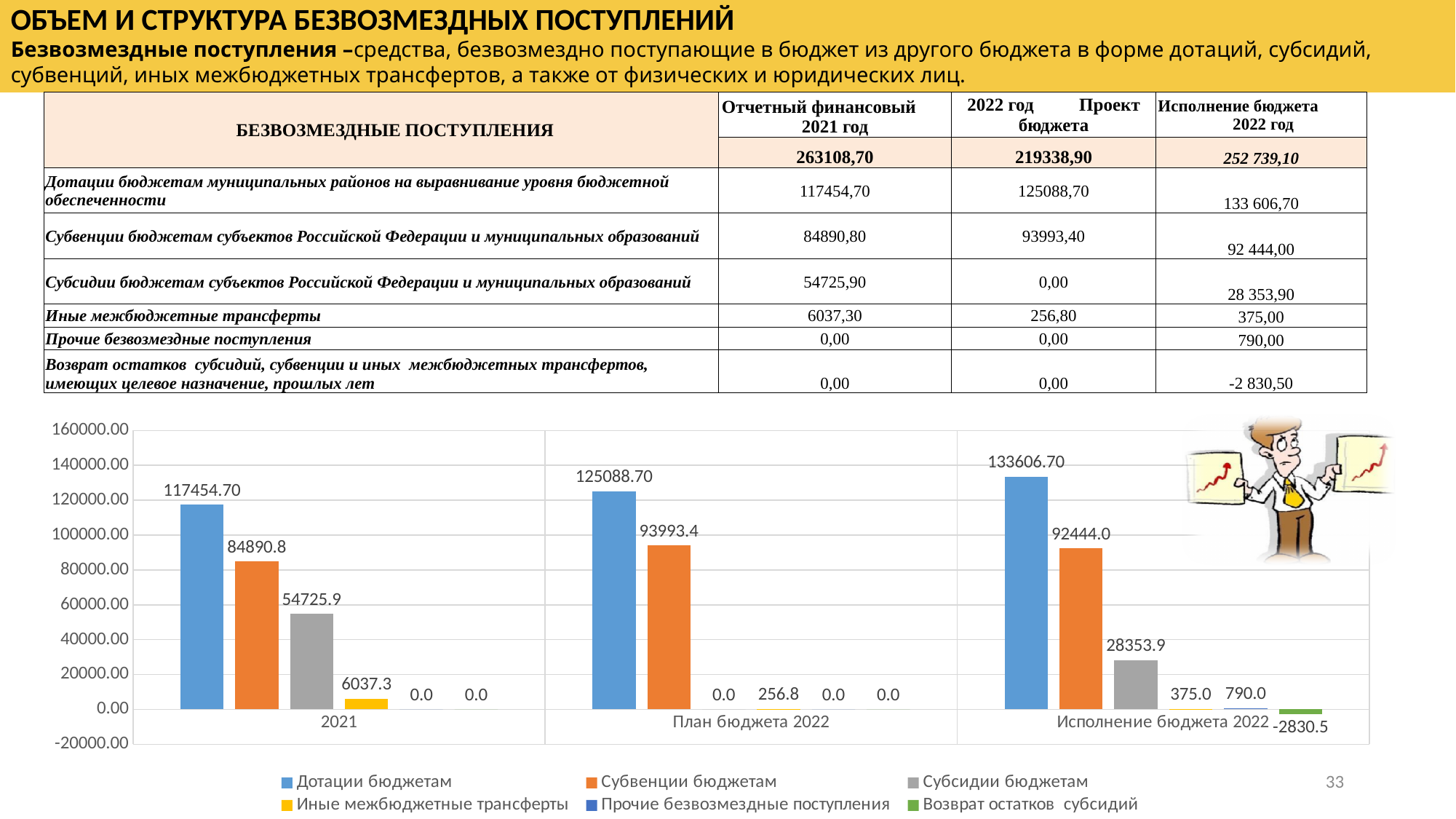
How many series does the chart legend list? 6 What is the difference between Субсидии бюджетам for 2021 and for Исполнение бюджета 2022 in the chart? 26372.0 What is the value of Возврат остатков субсидий for Исполнение бюджета 2022 in the chart? -2830.5 What type of chart is shown on the slide? bar chart In which category does Дотации бюджетам reach its highest value in the chart? Исполнение бюджета 2022 How many categories are shown on the x axis of the chart? 3 By how much does Дотации бюджетам for Исполнение бюджета 2022 exceed Дотации бюджетам for План бюджета 2022 in the chart? 8518.00 Which is larger in the chart: Субвенции бюджетам for План бюджета 2022 or for Исполнение бюджета 2022? План бюджета 2022 Is the value of Субсидии бюджетам for 2021 greater or less than 60000.00? less What is the value of Дотации бюджетам for 2021 in the chart? 117454.70 In which category is Субсидии бюджетам lowest in the chart? План бюджета 2022 What is the value of Субвенции бюджетам for Исполнение бюджета 2022 in the chart? 92444.0